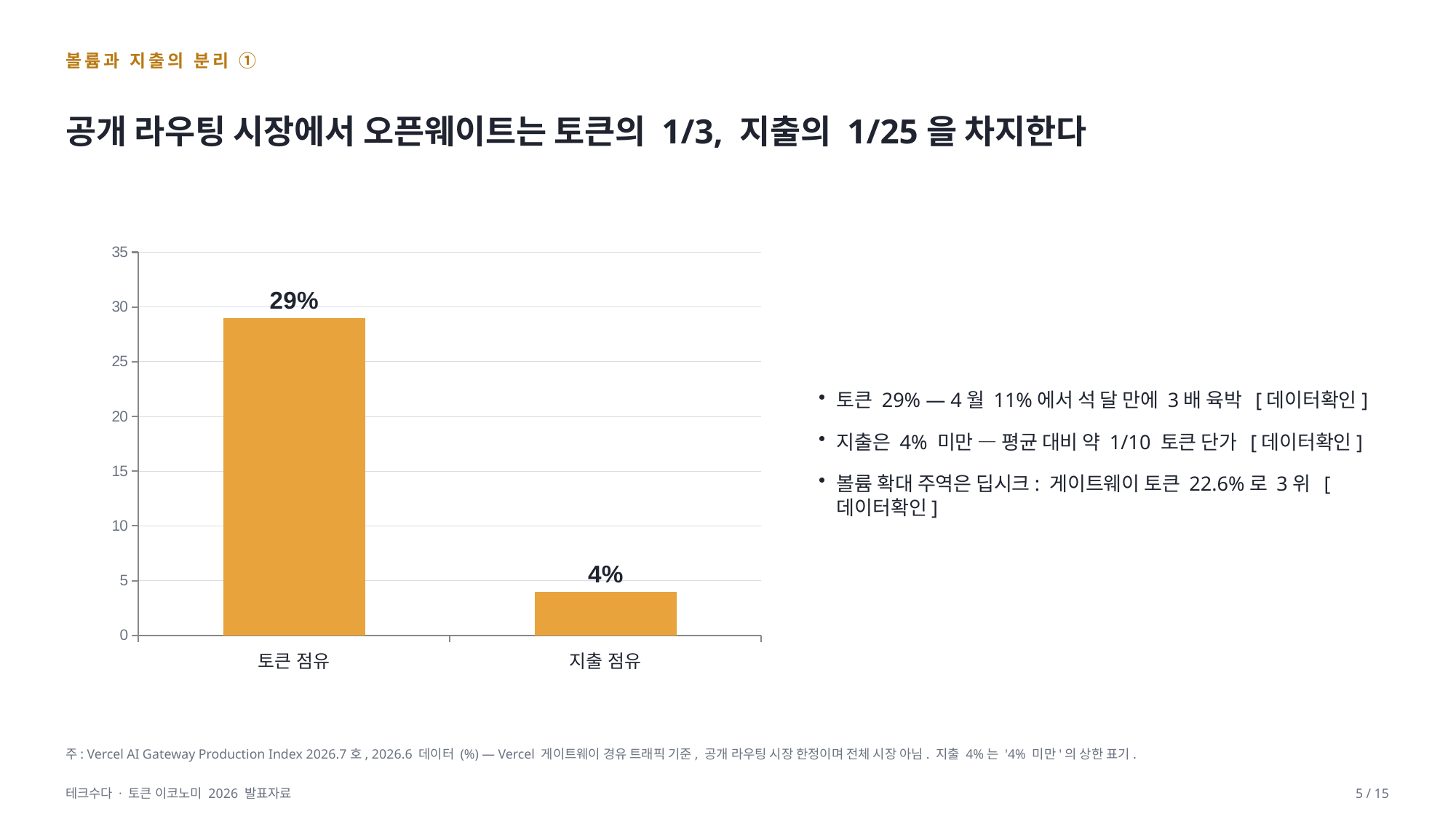
What is the difference between the values for 토큰 점유 and 지출 점유? 25% Is the value for 지출 점유 greater or less than 5? less Which category has the lowest value? 지출 점유 Which category has the highest value? 토큰 점유 Is the value for 토큰 점유 greater or less than 25? greater What kind of chart is shown on the slide? bar chart How many categories are shown on the x axis? 2 What colour are the bars in the chart? orange Which is larger, the value for 토큰 점유 or the value for 지출 점유? 토큰 점유 What is the value for 지출 점유? 4% What is the value for 토큰 점유? 29% What is the maximum value shown on the y axis? 35